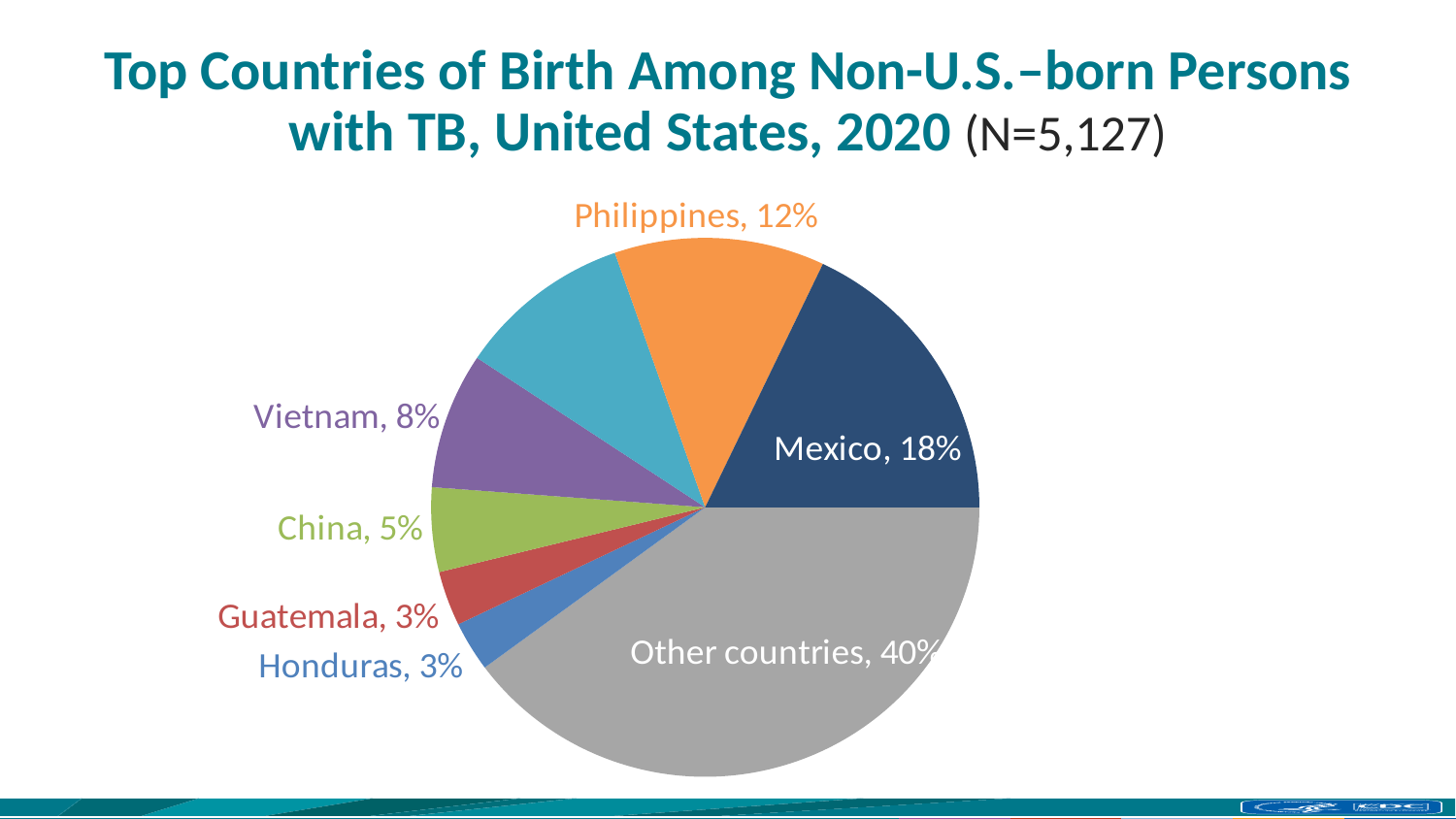
How many percentage points larger is Mexico's share than the Philippines' share? 6 percentage points What percentage is shown for China? 5% Which slice of the pie is the largest? Other countries Which has a larger share, Vietnam or China? Vietnam What percentage of non-U.S.-born persons with TB were born in Mexico? 18% What is the total number of persons (N) given in the chart title? 5,127 What share of the pie is labeled Philippines? 12% What kind of chart is shown on the slide? pie chart What percentage is shown for Vietnam? 8% What percentage is shown for Guatemala? 3% What percentage is shown for Other countries? 40% Which individually named country has the largest share? Mexico